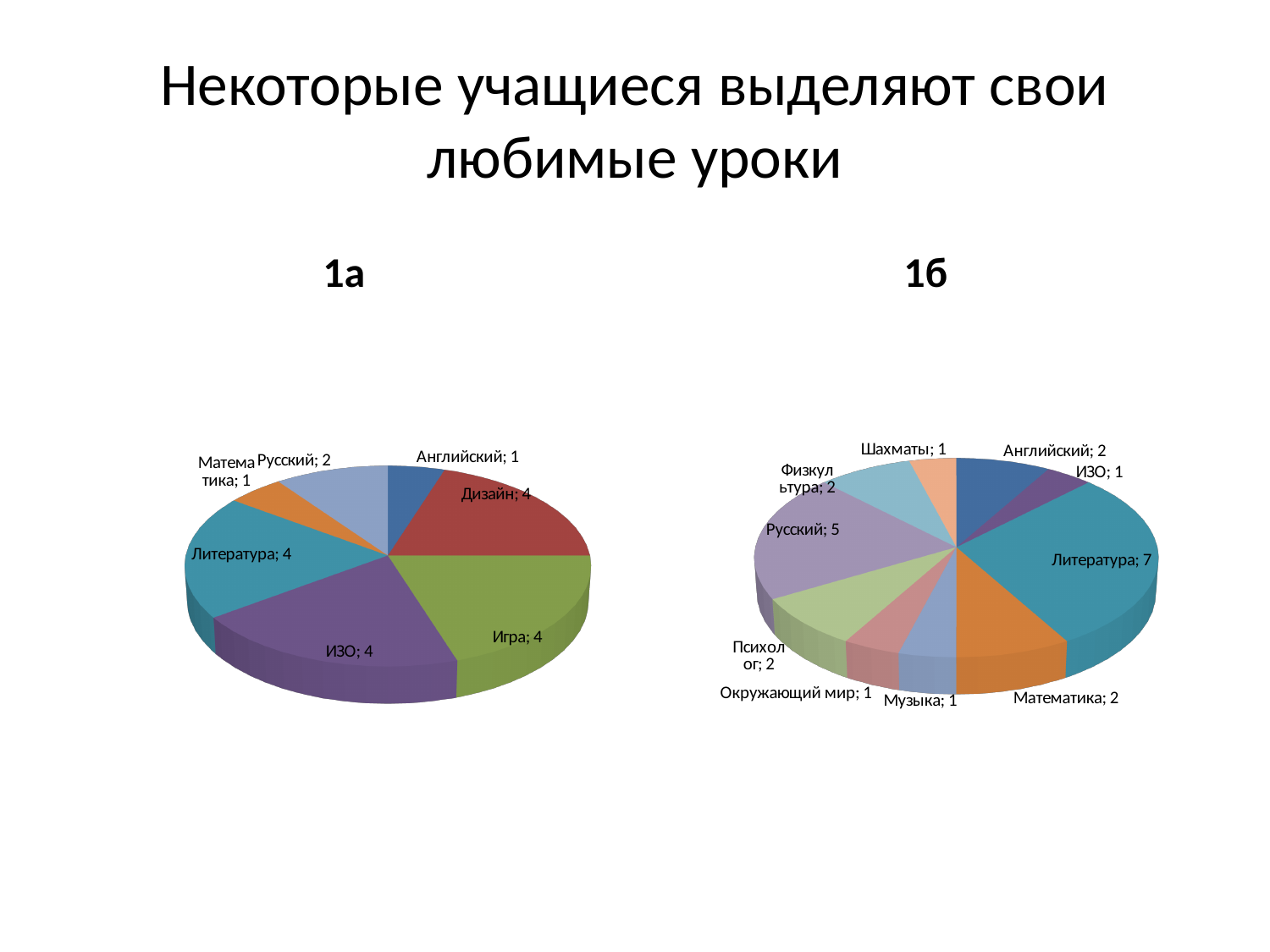
In the 1б pie chart, what is the value for Математика? 2 How many categories are shown in the 1а pie chart? 7 In the 1б pie chart, what is the difference between the values for Литература and Русский? 2 In the 1б pie chart, which is larger: Английский or Шахматы? Английский What kind of chart is the 1б chart? Pie chart In the 1а pie chart, which is larger: Литература or Русский? Литература In the 1а pie chart, what is the value for Математика? 1 How many categories are shown in the 1б pie chart? 10 In the 1а pie chart, what share of the total does Дизайн represent? 20% In the 1а pie chart, what is the value for Дизайн? 4 In the 1б pie chart, what is the value for Русский? 5 In the 1б pie chart, which category has the highest value? Литература